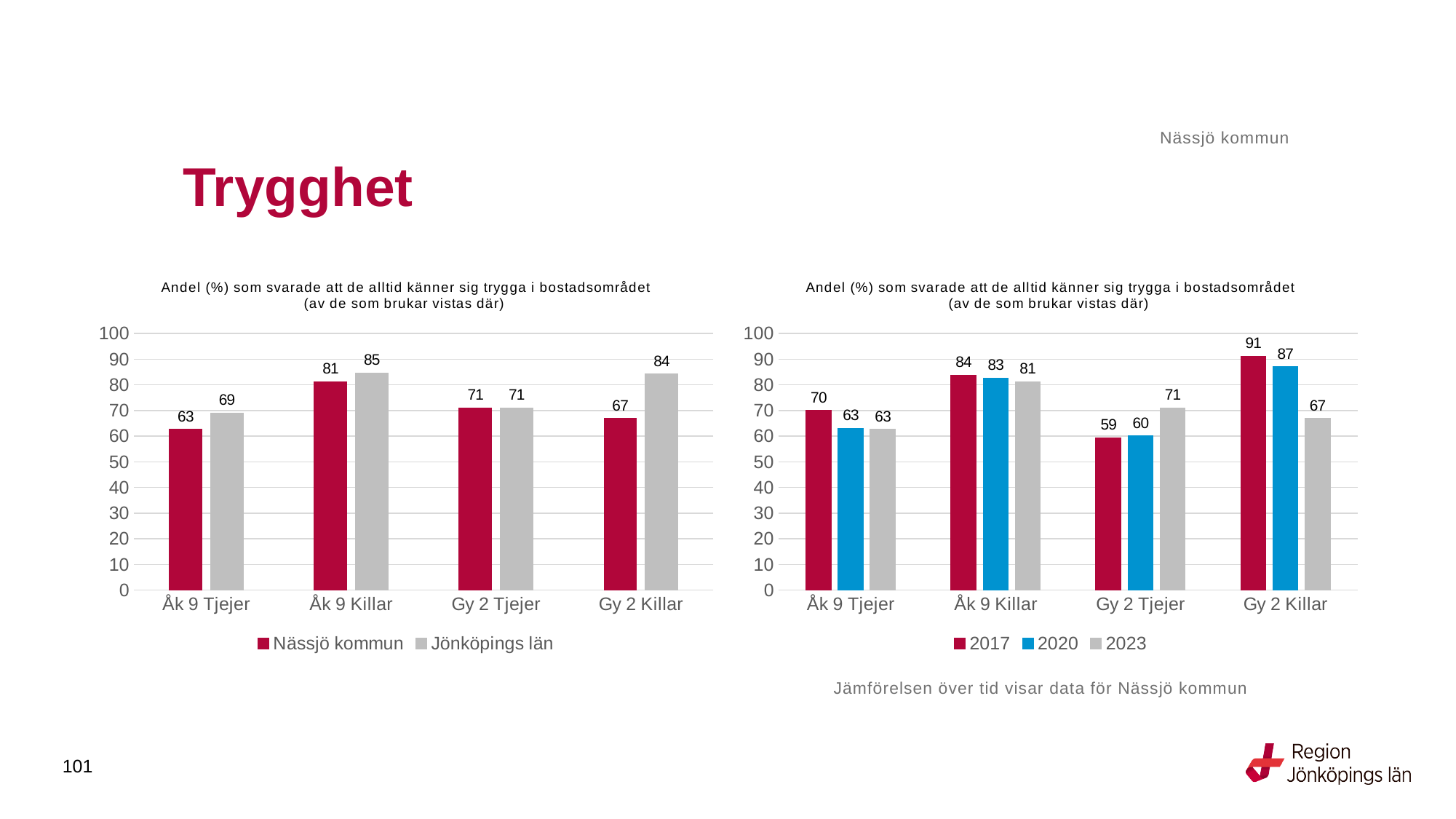
In the left chart, which category has the highest value for Jönköpings län? Åk 9 Killar In the right chart, how many categories are shown on the x axis? 4 In the left chart, what is the difference between Jönköpings län and Nässjö kommun for Gy 2 Killar? 17 In the right chart, how many series does the legend list? 3 In the right chart, what is the value for 2020 for Gy 2 Tjejer? 60 What kind of chart is the left chart? bar chart In the left chart, how many series does the legend list? 2 In the right chart, is the 2023 value for Gy 2 Killar larger or smaller than the 2020 value for Gy 2 Killar? smaller In the right chart, which category has the lowest value for 2017? Gy 2 Tjejer In the left chart, what is the value for Jönköpings län for Gy 2 Killar? 84 In the right chart, what is the value for 2017 for Gy 2 Killar? 91 In the left chart, what is the value for Nässjö kommun for Åk 9 Tjejer? 63